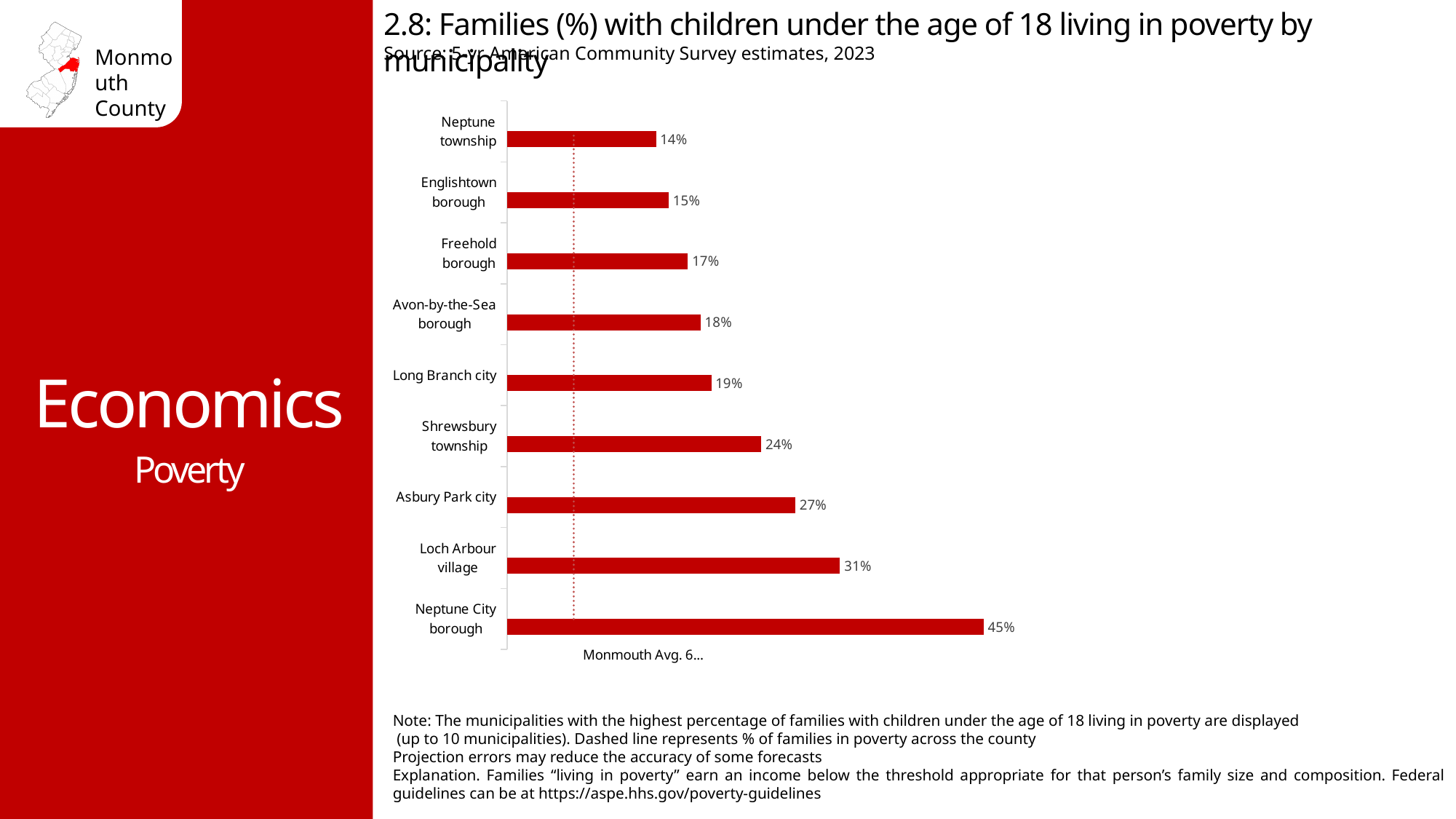
Which has a higher value, Avon-by-the-Sea borough or Englishtown borough? Avon-by-the-Sea borough What kind of chart is shown on the slide? Bar chart How many municipalities are shown on the chart? 9 Which municipality has the highest percentage of families with children under 18 living in poverty? Neptune City borough What is the value for Shrewsbury township? 24% What is the value for Neptune City borough? 45% What is the value for Asbury Park city? 27% What is the difference between the values for Asbury Park city and Freehold borough? 10% What is the difference between the values for Neptune City borough and Loch Arbour village? 14% Which municipality has the lowest percentage shown on the chart? Neptune township What is the value for Long Branch city? 19% What does the dashed vertical line on the chart represent? Monmouth County average % of families in poverty